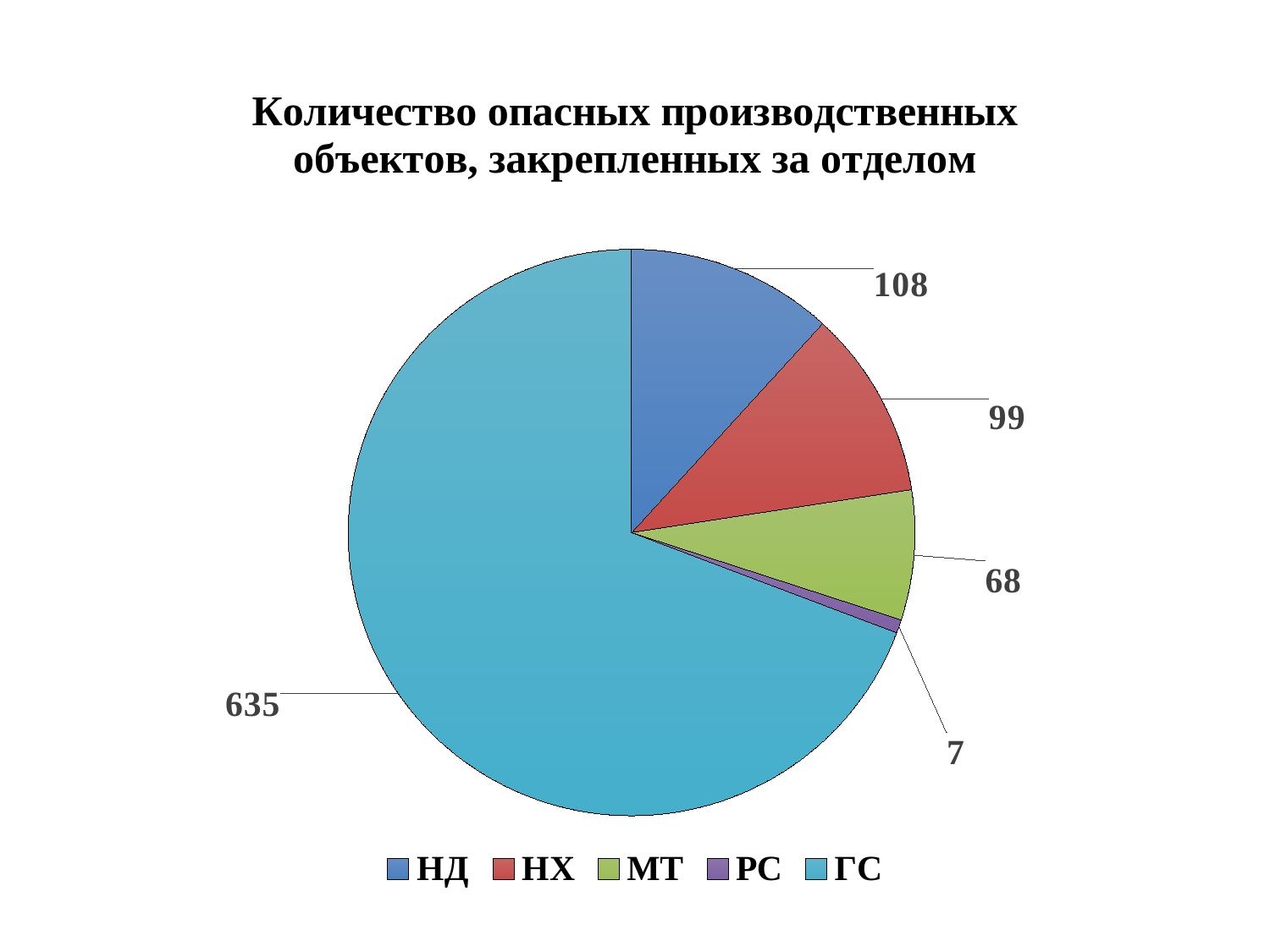
What is the title of the chart? Количество опасных производственных объектов, закрепленных за отделом Which category has the smallest slice of the pie chart? РС What is the value for НД in the pie chart? 108 What type of chart is shown on the slide? Pie chart Which is larger, the value for НХ or the value for МТ? НХ What is the difference between the values for НД and НХ? 9 What is the value for МТ in the pie chart? 68 How many categories does the legend of the pie chart list? 5 What is the difference between the values for ГС and МТ? 567 What is the value for РС in the pie chart? 7 What is the value for ГС in the pie chart? 635 Which category has the largest slice of the pie chart? ГС